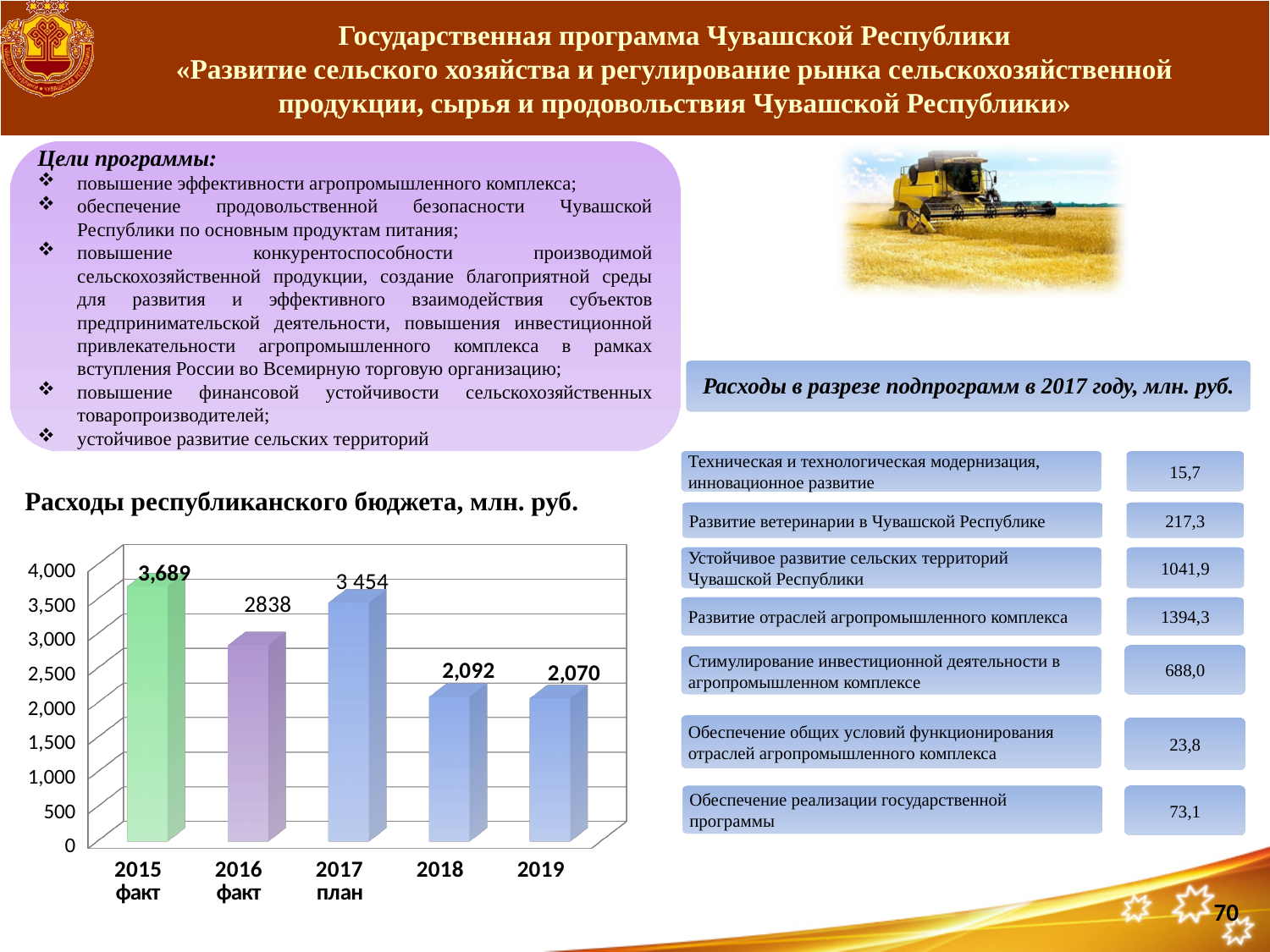
What is the value for 2019 in the chart 'Расходы республиканского бюджета, млн. руб.'? 2,070 Which year has the lowest value in the chart 'Расходы республиканского бюджета, млн. руб.'? 2019 Which is larger in the chart 'Расходы республиканского бюджета, млн. руб.': the value for 2016 факт or for 2017 план? 2017 план What is the value for 2016 факт in the chart 'Расходы республиканского бюджета, млн. руб.'? 2838 What type of chart is 'Расходы республиканского бюджета, млн. руб.'? Bar chart Which year has the highest value in the chart 'Расходы республиканского бюджета, млн. руб.'? 2015 факт What is the value for 2017 план in the chart 'Расходы республиканского бюджета, млн. руб.'? 3 454 What is the difference between the 2018 and 2019 values in the chart 'Расходы республиканского бюджета, млн. руб.'? 22 What is the title of the chart on the slide? Расходы республиканского бюджета, млн. руб. What is the difference between the 2015 факт and 2017 план values in the chart 'Расходы республиканского бюджета, млн. руб.'? 235 How many bars are shown in the chart 'Расходы республиканского бюджета, млн. руб.'? 5 What is the value for 2015 факт in the chart 'Расходы республиканского бюджета, млн. руб.'? 3,689